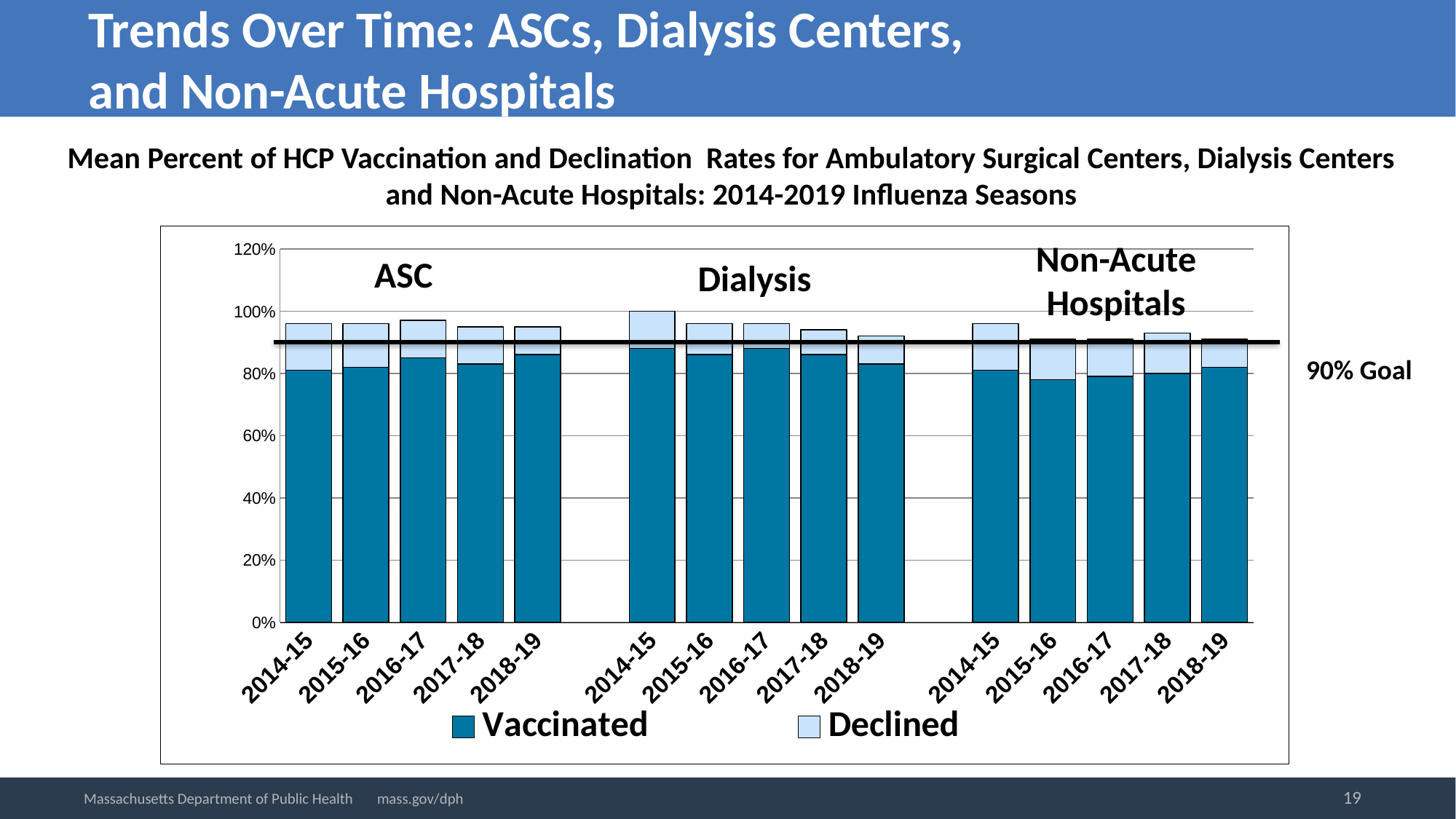
How many influenza seasons are shown for each facility type? 5 What goal does the horizontal black line across the chart represent? 90% Goal Is the Vaccinated value for Non-Acute Hospitals in 2015-16 greater or less than 80%? less Is the Vaccinated value for Dialysis in 2016-17 greater or less than 80%? greater Which is larger: the Vaccinated value for Dialysis in 2014-15 or the Vaccinated value for Non-Acute Hospitals in 2015-16? Dialysis 2014-15 Is the total (Vaccinated plus Declined) for Dialysis in 2014-15 greater or less than 90%? greater Which is larger: the Vaccinated value for ASC in 2014-15 or the Vaccinated value for Dialysis in 2014-15? Dialysis 2014-15 How many bars are plotted in the chart in total? 15 What are the two series named in the legend? Vaccinated and Declined What kind of chart is shown on the slide? Stacked bar chart How many series does the legend list? 2